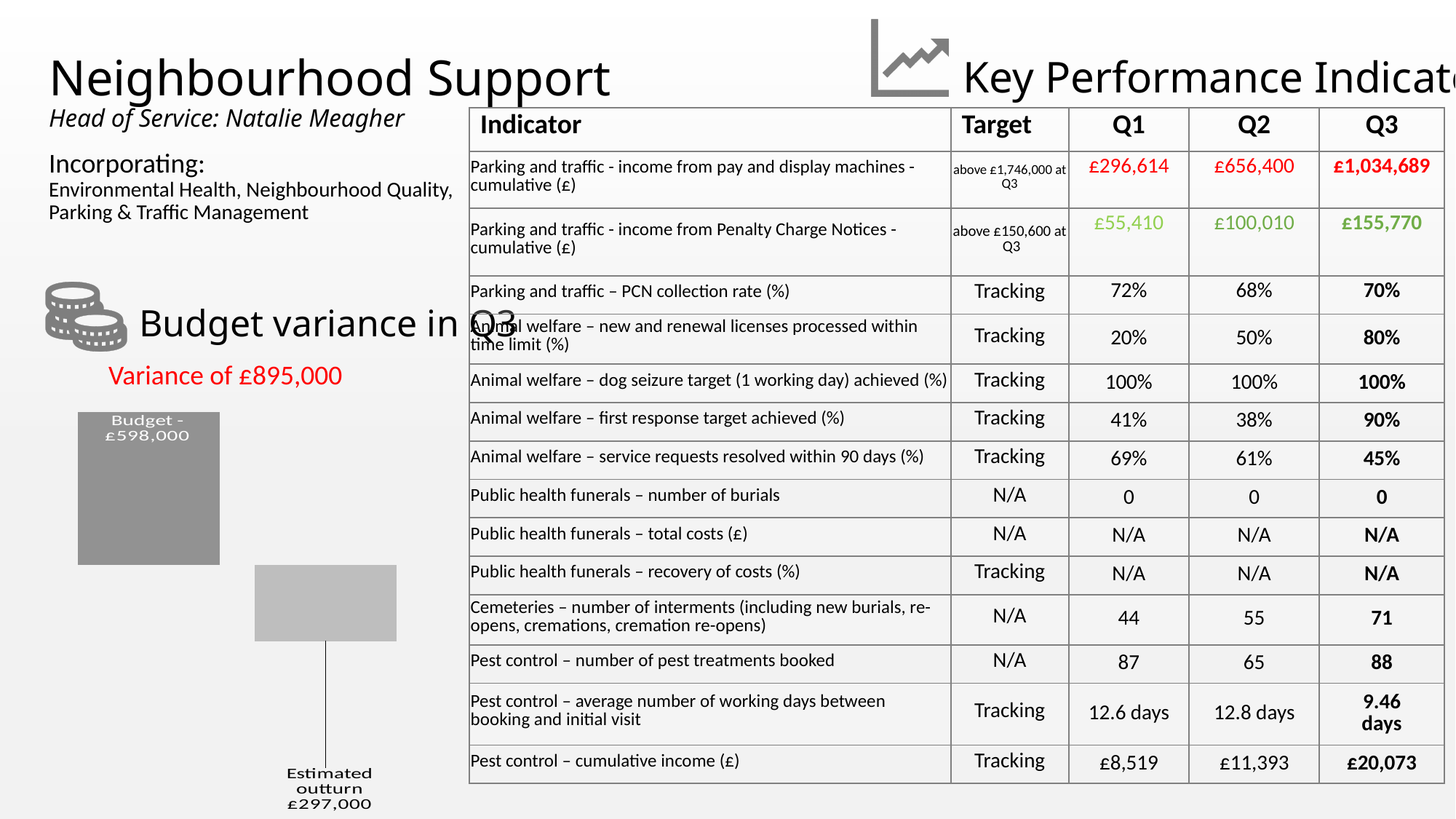
Which bar in the Budget variance in Q3 chart has the higher value? Budget What are the labels of the two bars in the Budget variance in Q3 chart? Budget and Estimated outturn What is the value of the Estimated outturn bar in the Budget variance in Q3 chart? £297,000 What is the title of the chart on the left of the slide? Budget variance in Q3 How many bars are plotted in the Budget variance in Q3 chart? 2 In the Budget variance in Q3 chart, is the Budget value larger or smaller than the Estimated outturn value? larger Which bar in the Budget variance in Q3 chart has the lower value? Estimated outturn What is the value of the Budget bar in the Budget variance in Q3 chart? £598,000 What type of chart is used to show the budget variance in Q3? bar chart